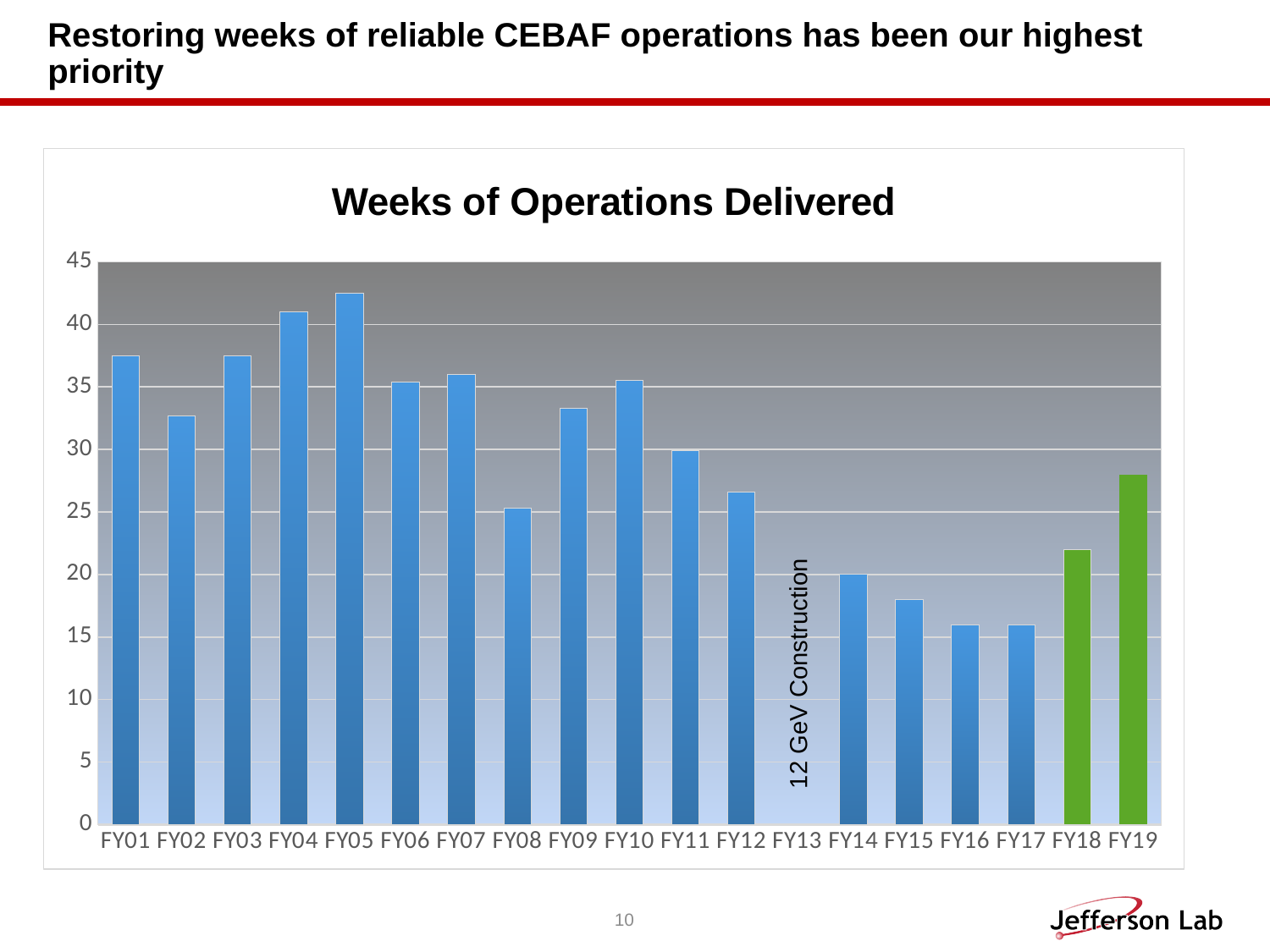
What kind of chart is shown on the slide? bar chart Is the value for FY15 greater or less than 20? less How many fiscal years are labelled on the x axis? 19 Which fiscal year has the highest number of weeks of operations delivered? FY05 Which is larger, the value for FY02 or FY03? FY03 Do the values rise or fall from FY16 to FY19? rise Is the value for FY01 greater or less than 35? greater Is the value for FY19 greater or less than 25? greater What is the title of the chart? Weeks of Operations Delivered What text appears in place of a bar for FY13? 12 GeV Construction Which is larger, the value for FY18 or FY19? FY19